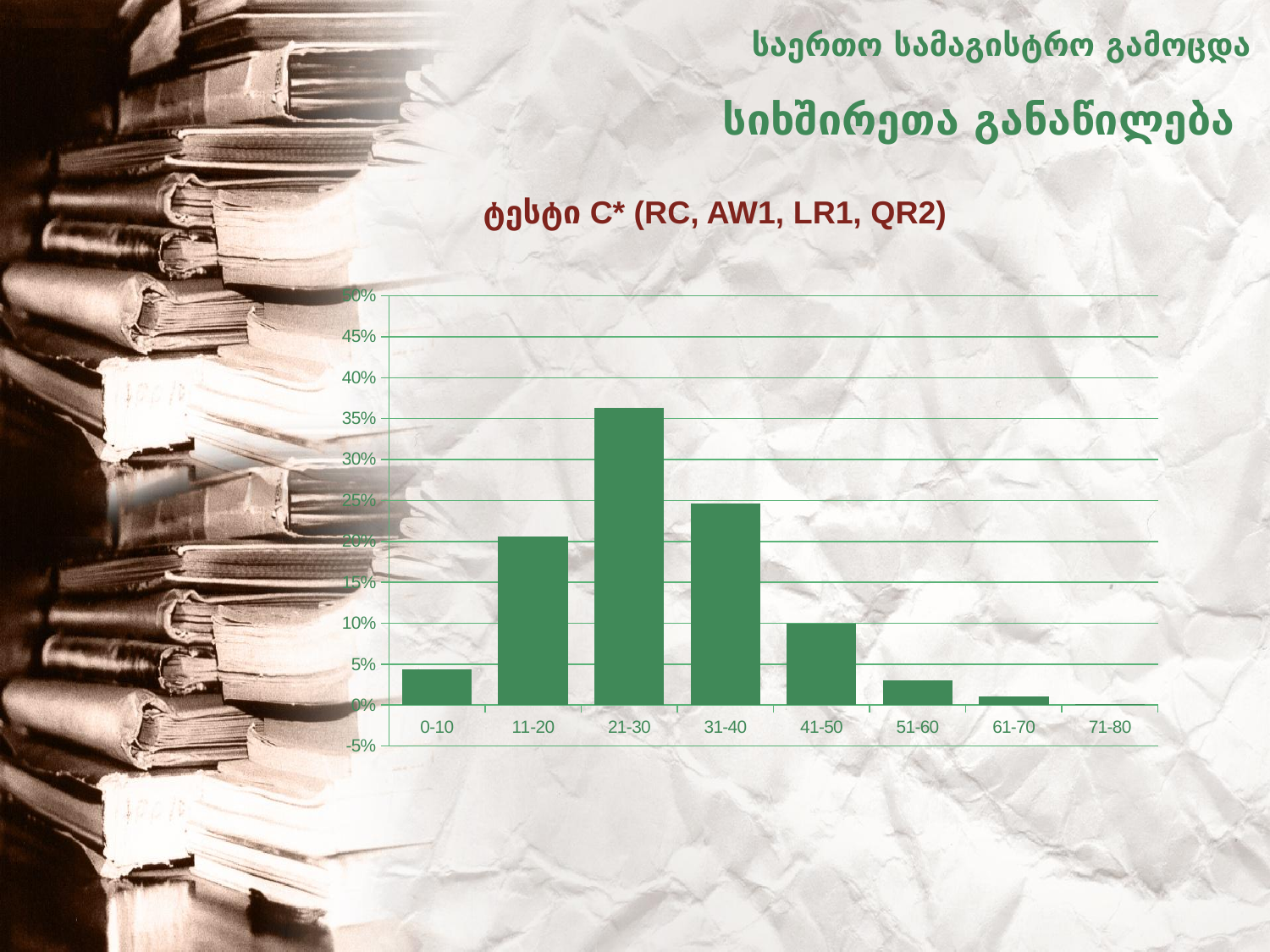
Is the value for 21-30 greater or less than 30%? greater Which is larger, the value for 21-30 or the value for 31-40? 21-30 Which is larger, the value for 11-20 or the value for 41-50? 11-20 How many score-range categories are shown on the x axis? 8 Is the value for 0-10 greater or less than 10%? less Which category has the highest bar? 21-30 Is the value for 11-20 greater or less than 25%? less Which category has the lowest bar? 71-80 Moving from 21-30 to 71-80 along the x axis, do the values rise or fall? fall What kind of chart is shown on the slide? bar chart